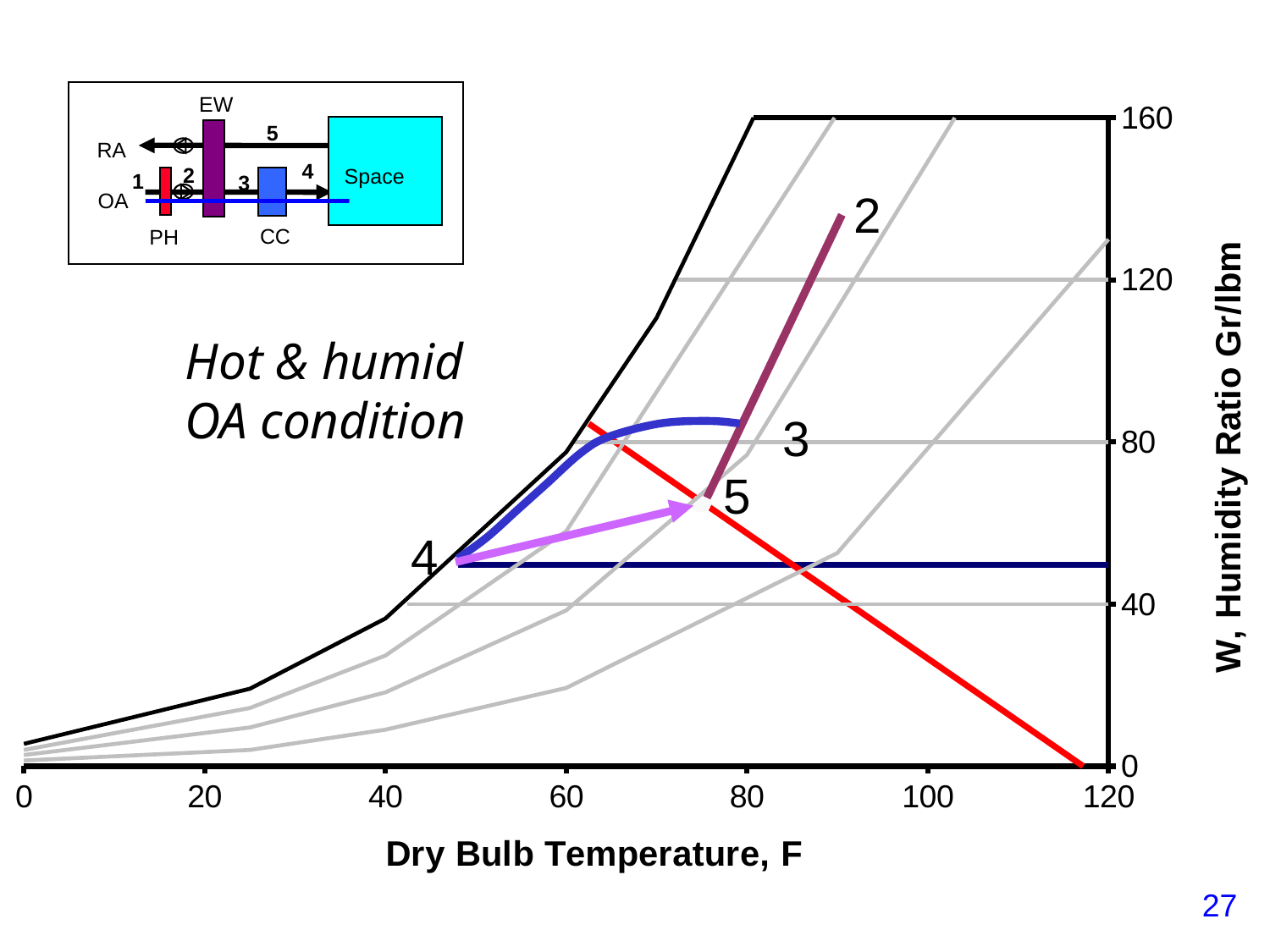
Is the dry bulb temperature at point 5 greater or less than 80? less Which point has the higher dry bulb temperature, point 2 or point 5? point 2 What kind of chart is shown on the slide? line chart Which point has the higher humidity ratio, point 2 or point 4? point 2 What is the title of the vertical axis of the chart? W, Humidity Ratio Gr/lbm Is the dry bulb temperature at point 2 greater or less than 80? greater Is the dry bulb temperature at point 4 greater or less than 60? less What is the title of the horizontal axis of the chart? Dry Bulb Temperature, F Of the labeled points 2, 4 and 5, which has the lowest dry bulb temperature? point 4